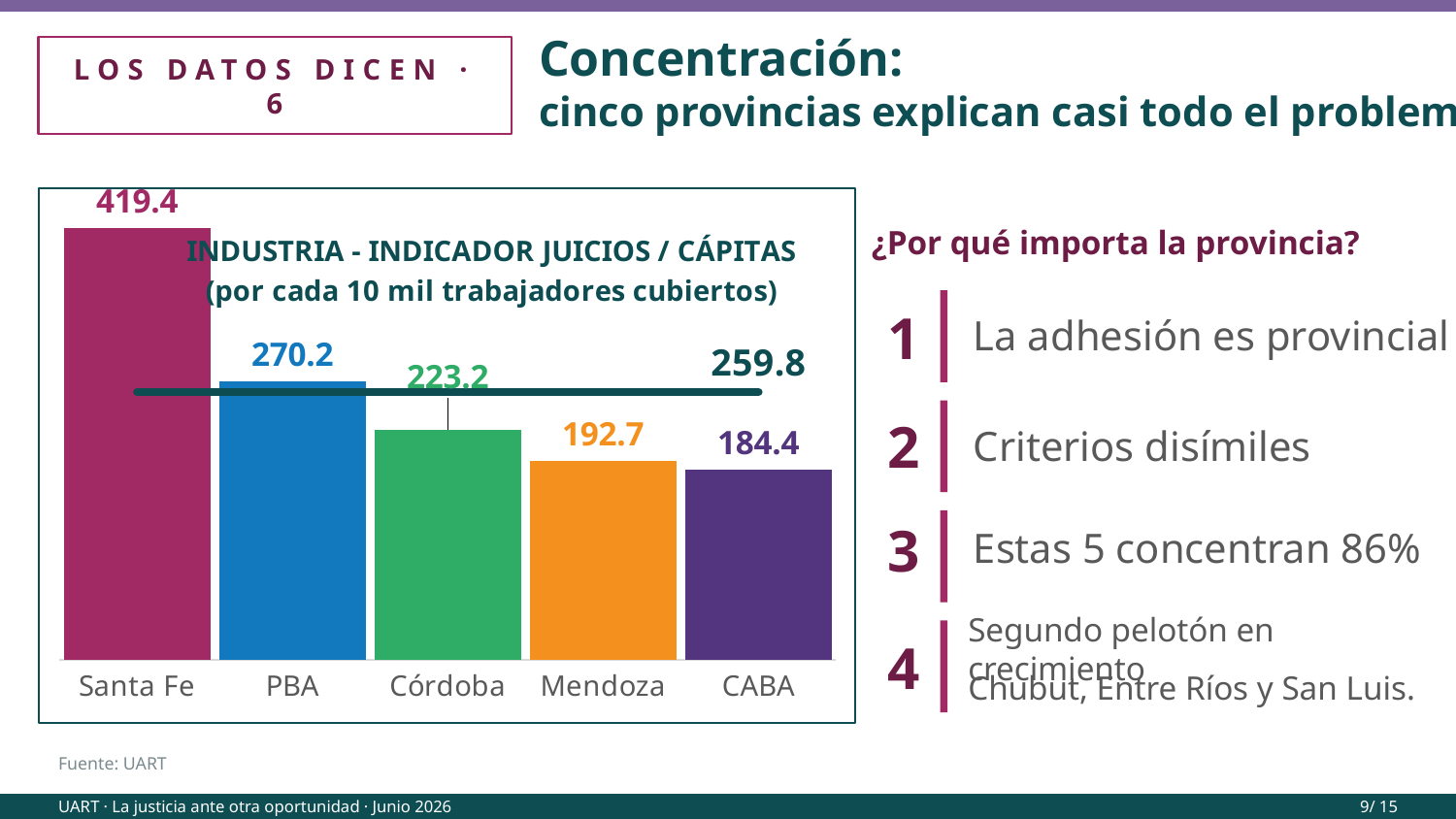
What is the value for Santa Fe? 419.4 What is the difference between the values for Santa Fe and PBA? 149.2 Which province has the lowest value? CABA Which is larger, the value for PBA or the value for Córdoba? PBA What is the difference between the values for Mendoza and CABA? 8.3 Do the bar values rise or fall from left to right across the chart? Fall What is the value for CABA? 184.4 What kind of chart is shown on the slide? Bar chart What value is labelled on the horizontal reference line drawn across the chart? 259.8 How many provinces are shown in the chart? 5 Which province has the highest value? Santa Fe What is the value for Córdoba? 223.2